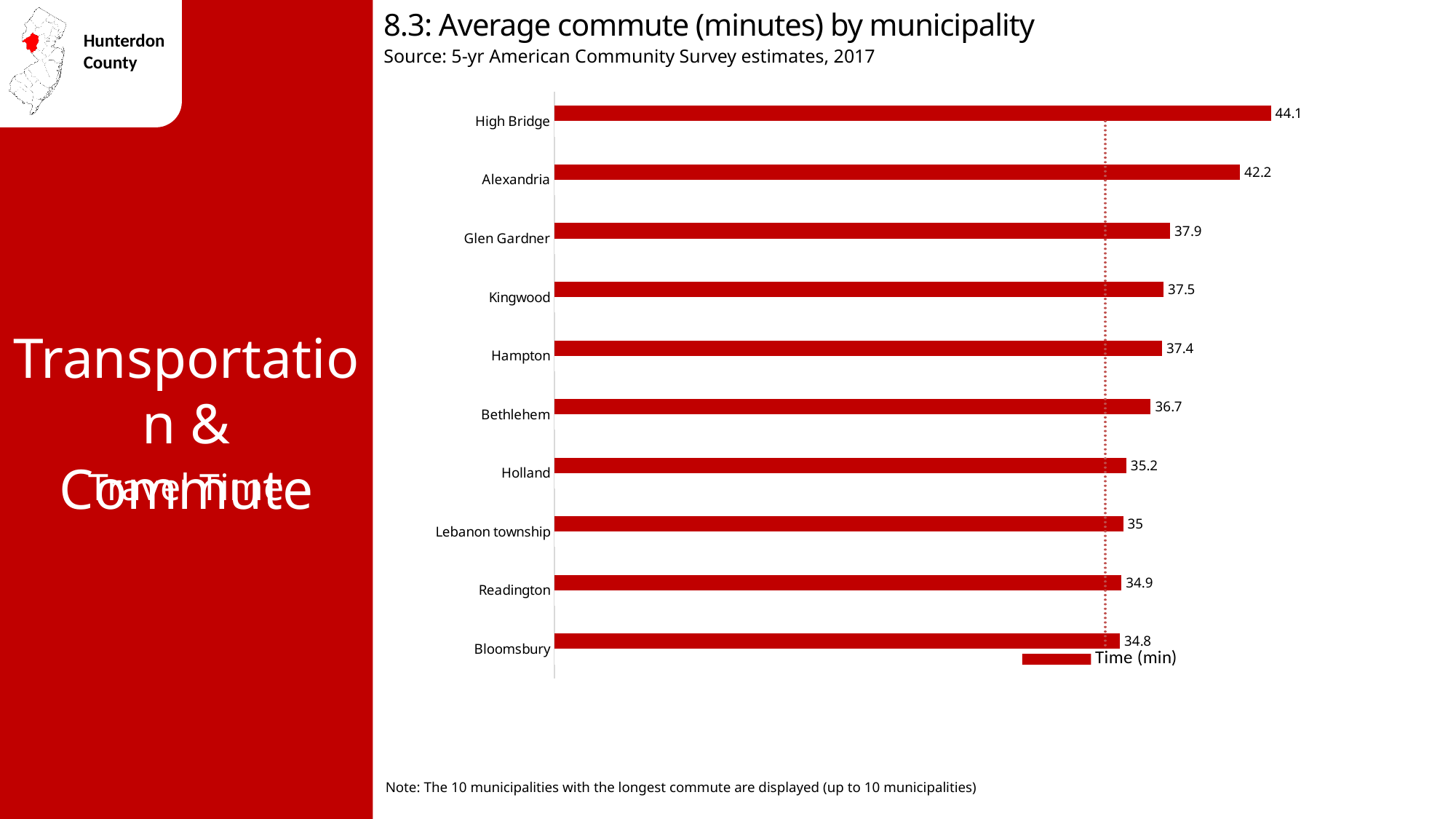
What is the difference in average commute time between High Bridge and Alexandria? 1.9 What is the difference in average commute time between Glen Gardner and Holland? 2.7 Which municipality shown has the shortest average commute? Bloomsbury Which has a longer average commute, Bethlehem or Readington? Bethlehem Which municipality has the longest average commute? High Bridge How many series does the legend list? 1 What is the legend entry for the series in the chart? Time (min) What is the average commute time for Kingwood? 37.5 What is the average commute time for Lebanon township? 35 What type of chart is shown? Bar chart What is the average commute time for High Bridge? 44.1 How many municipalities are shown in the chart? 10